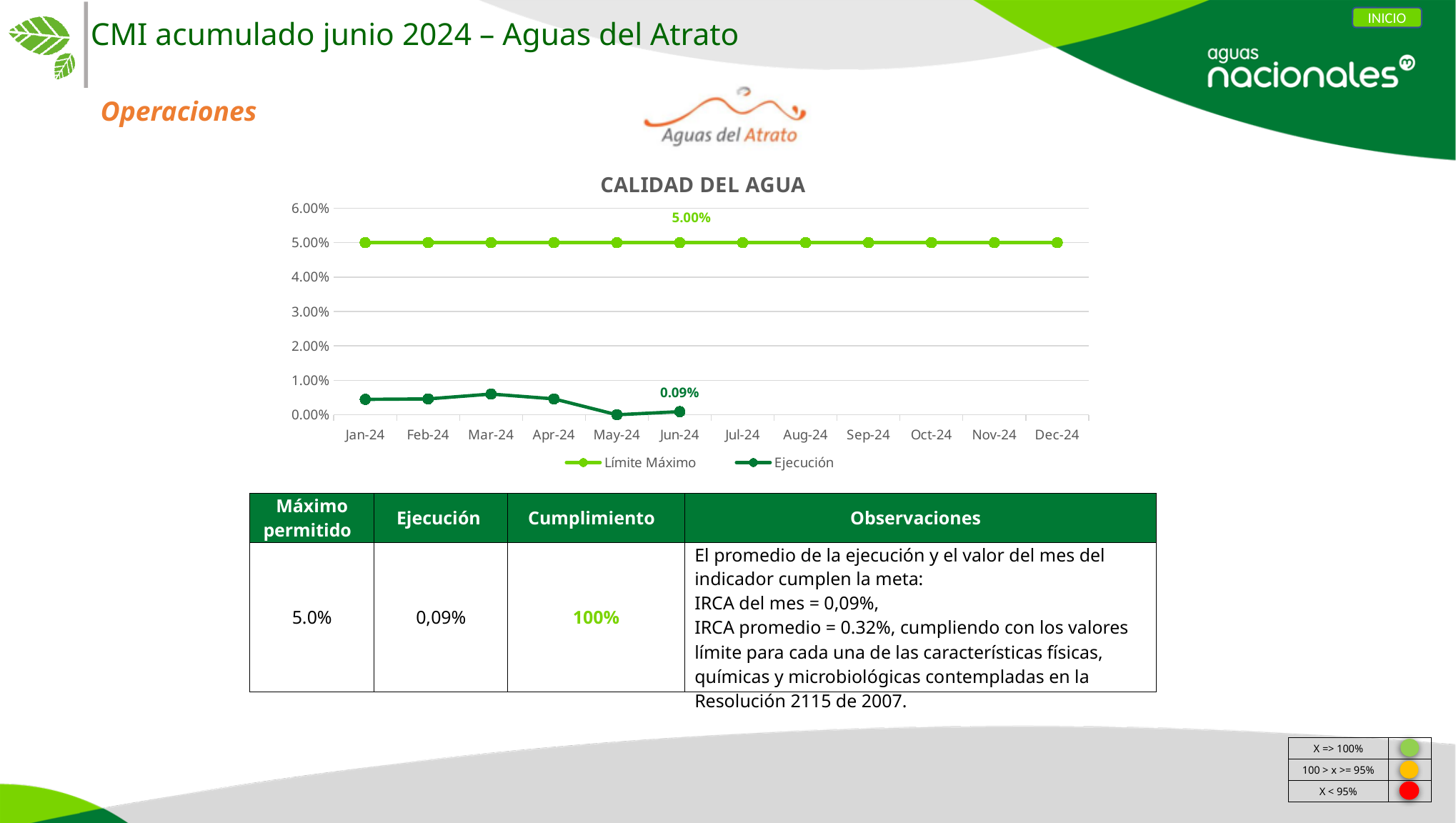
What is the Ejecución value labelled for Jun-24 in the CALIDAD DEL AGUA chart? 0.09% What kind of chart is shown under the title CALIDAD DEL AGUA? line chart How many series does the legend of the CALIDAD DEL AGUA chart list? 2 What are the two series named in the legend of the CALIDAD DEL AGUA chart? Límite Máximo and Ejecución How many data points does the Ejecución series have in the CALIDAD DEL AGUA chart? 6 How many months are shown on the x axis of the CALIDAD DEL AGUA chart? 12 What is the difference between the Límite Máximo and Ejecución values labelled for Jun-24 in the CALIDAD DEL AGUA chart? 4.91% In which month does the Ejecución series reach its lowest point in the CALIDAD DEL AGUA chart? May-24 Is the Ejecución value for Mar-24 in the CALIDAD DEL AGUA chart greater or less than 1.00%? less Does the Ejecución series rise or fall from Apr-24 to May-24 in the CALIDAD DEL AGUA chart? fall In Jun-24, which series has the larger value in the CALIDAD DEL AGUA chart, Límite Máximo or Ejecución? Límite Máximo What is the Límite Máximo value labelled for Jun-24 in the CALIDAD DEL AGUA chart? 5.00%